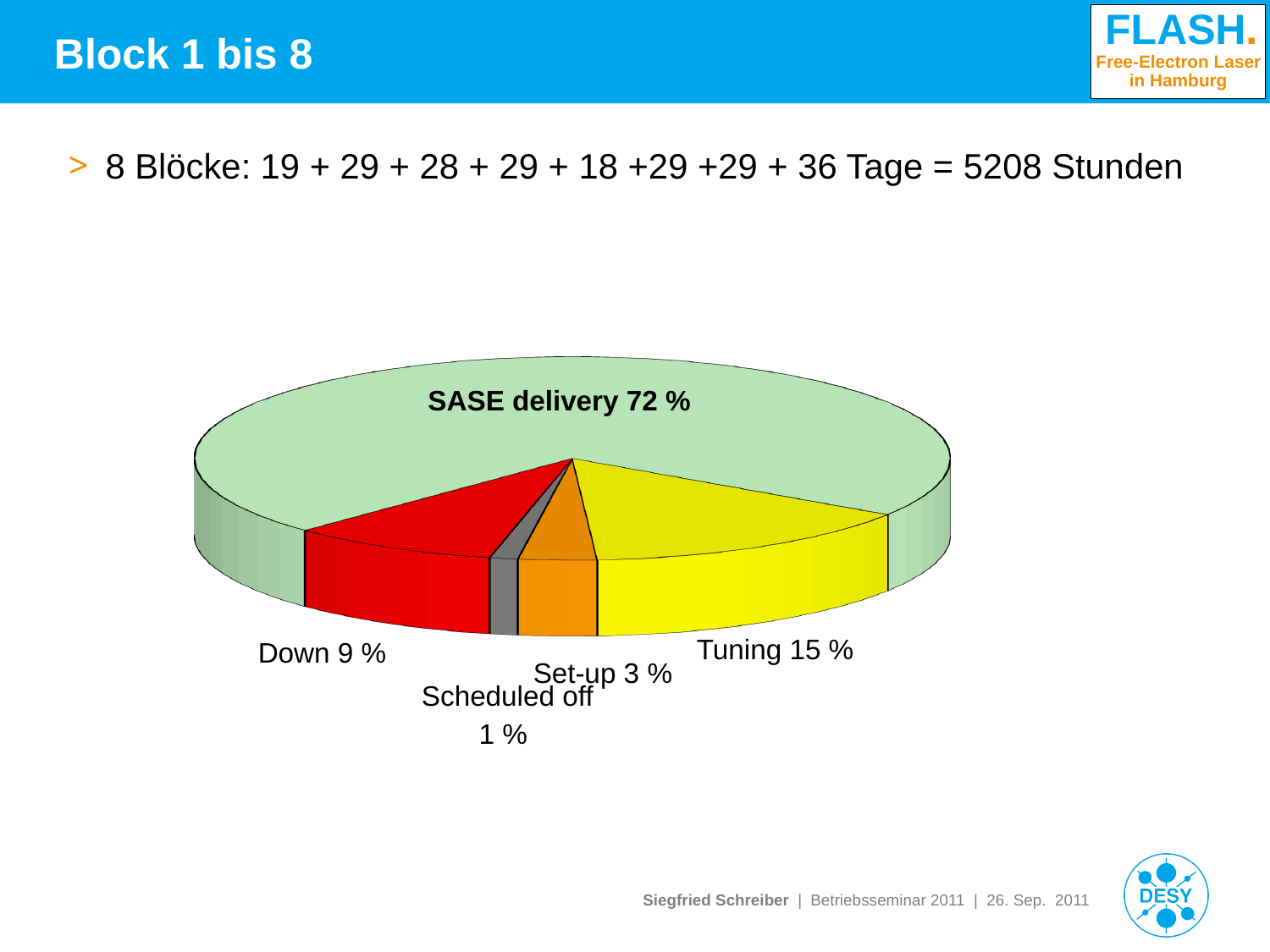
How many slices does the pie chart have? 5 What share of the pie is Down? 9 % What is the difference in percentage points between the Tuning slice and the Down slice? 6 % Which slice of the pie is the smallest? Scheduled off What share of the pie is Tuning? 15 % Which slice of the pie is the largest? SASE delivery What share of the pie is Scheduled off? 1 % Which is larger, the Tuning slice or the Down slice? Tuning What kind of chart is shown on the slide? Pie chart What colour is the SASE delivery slice? Green